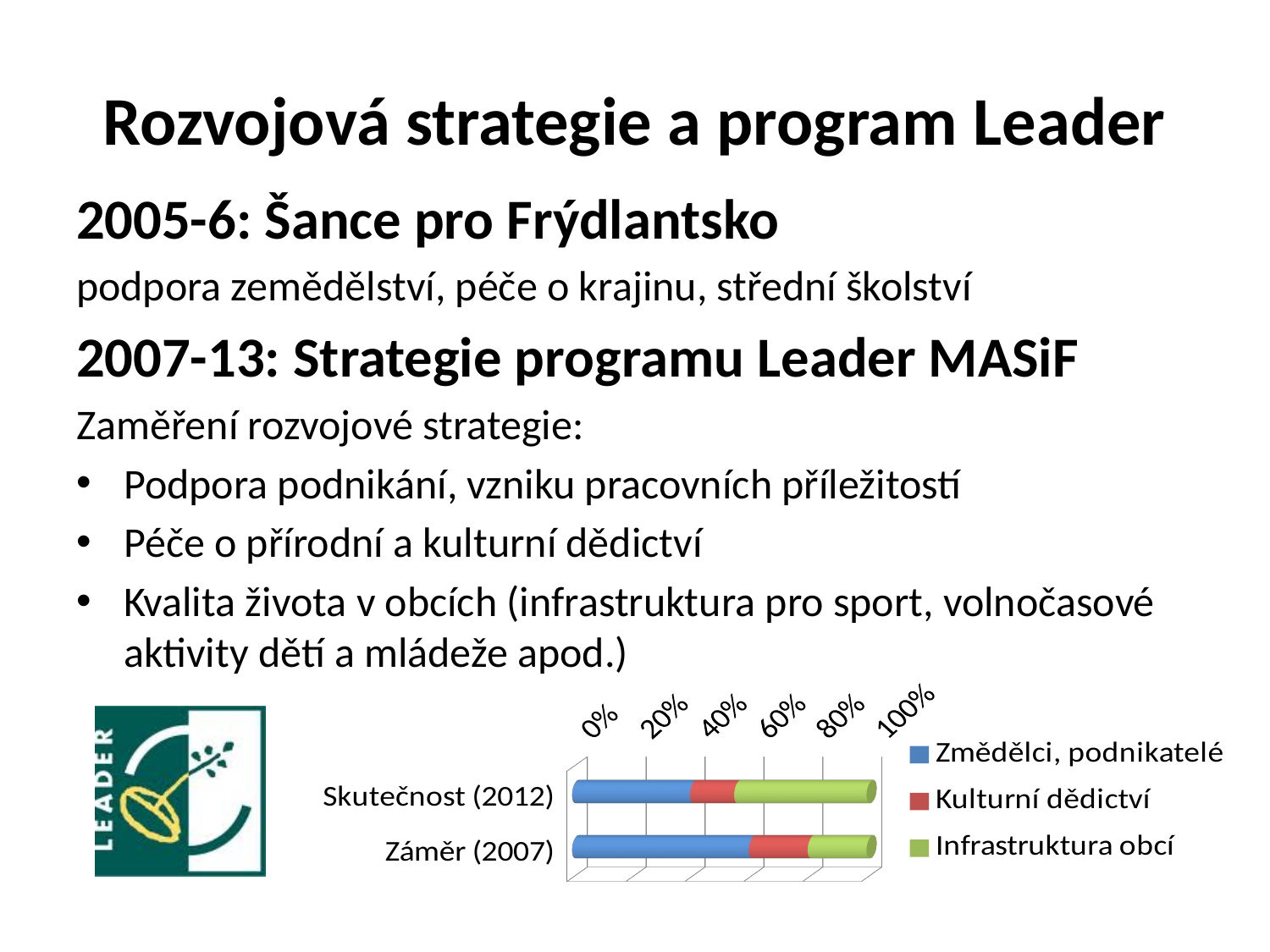
In the Záměr (2007) bar, which segment is larger: Změdělci, podnikatelé or Kulturní dědictví? Změdělci, podnikatelé How many series does the chart legend list? 3 Which bar has the larger share for Změdělci, podnikatelé: Skutečnost (2012) or Záměr (2007)? Záměr (2007) In the Skutečnost (2012) bar, which segment is larger: Kulturní dědictví or Infrastruktura obcí? Infrastruktura obcí Is the share of Změdělci, podnikatelé in the Záměr (2007) bar greater or less than 40%? greater What is the highest value shown on the chart's percentage axis? 100% Which series is shown in blue in the chart? Změdělci, podnikatelé How many categories (bars) does the chart show? 2 What colour represents Kulturní dědictví in the chart? Red What kind of chart is shown at the bottom of the slide? Stacked bar chart Is the share of Infrastruktura obcí in the Skutečnost (2012) bar greater or less than 20%? greater